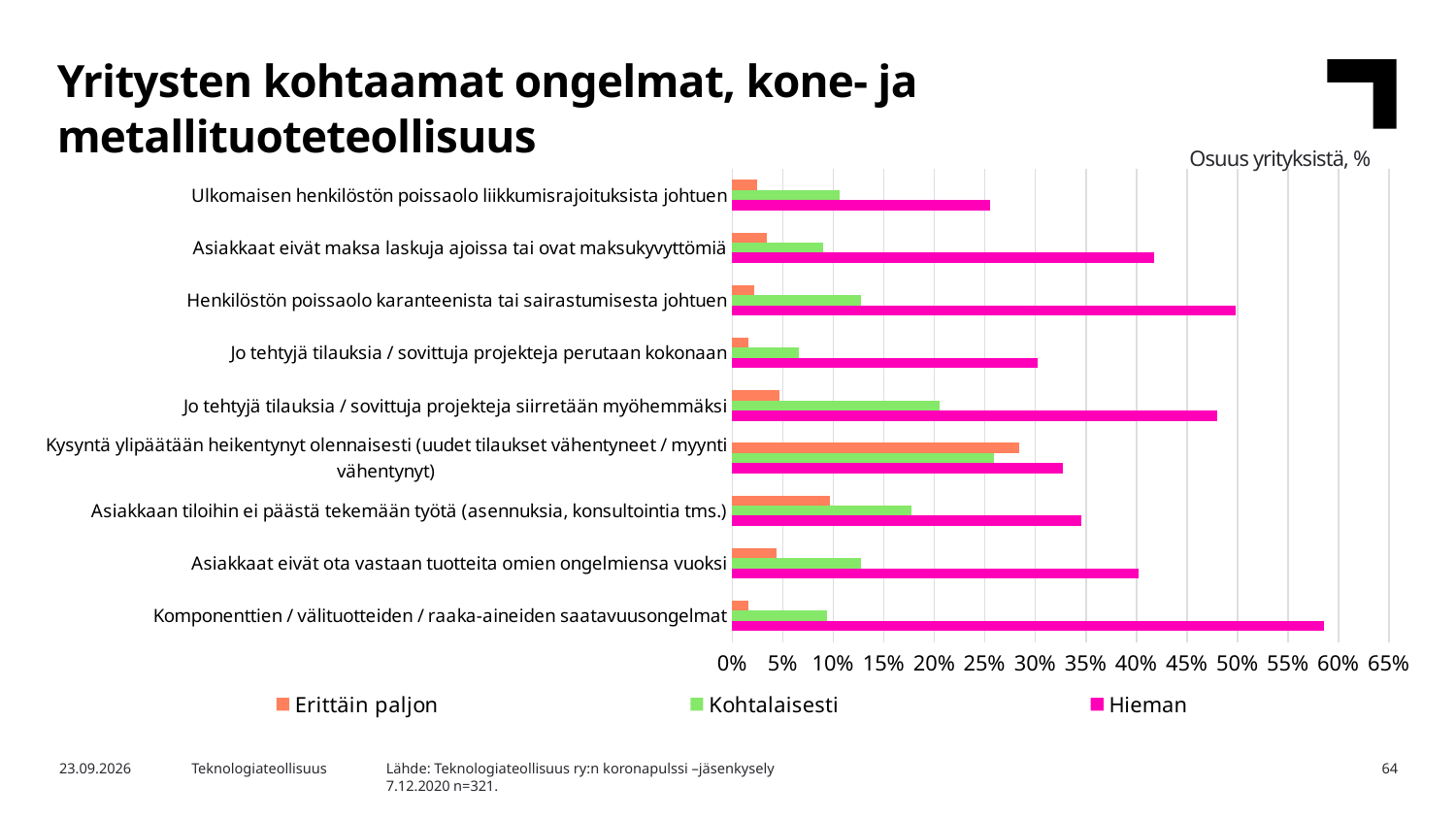
Is the 'Hieman' value for 'Asiakkaat eivät ota vastaan tuotteita omien ongelmiensa vuoksi' greater or less than 35%? greater Is the 'Hieman' value for 'Komponenttien / välituotteiden / raaka-aineiden saatavuusongelmat' greater or less than 55%? greater Which category has the highest value for the 'Hieman' series? Komponenttien / välituotteiden / raaka-aineiden saatavuusongelmat Is the 'Erittäin paljon' value for 'Ulkomaisen henkilöstön poissaolo liikkumisrajoituksista johtuen' greater or less than 5%? less For the 'Hieman' series, which is larger: 'Henkilöstön poissaolo karanteenista tai sairastumisesta johtuen' or 'Asiakkaat eivät maksa laskuja ajoissa tai ovat maksukyvyttömiä'? Henkilöstön poissaolo karanteenista tai sairastumisesta johtuen How many series does the legend list? 3 Which category has the highest value for the 'Erittäin paljon' series? Kysyntä ylipäätään heikentynyt olennaisesti (uudet tilaukset vähentyneet / myynti vähentynyt) What colour represents the 'Hieman' series in the legend? Magenta (pink) How many categories (problems) are plotted on the chart? 9 Which category has the lowest value for the 'Hieman' series? Ulkomaisen henkilöstön poissaolo liikkumisrajoituksista johtuen What kind of chart is shown on the slide? Bar chart